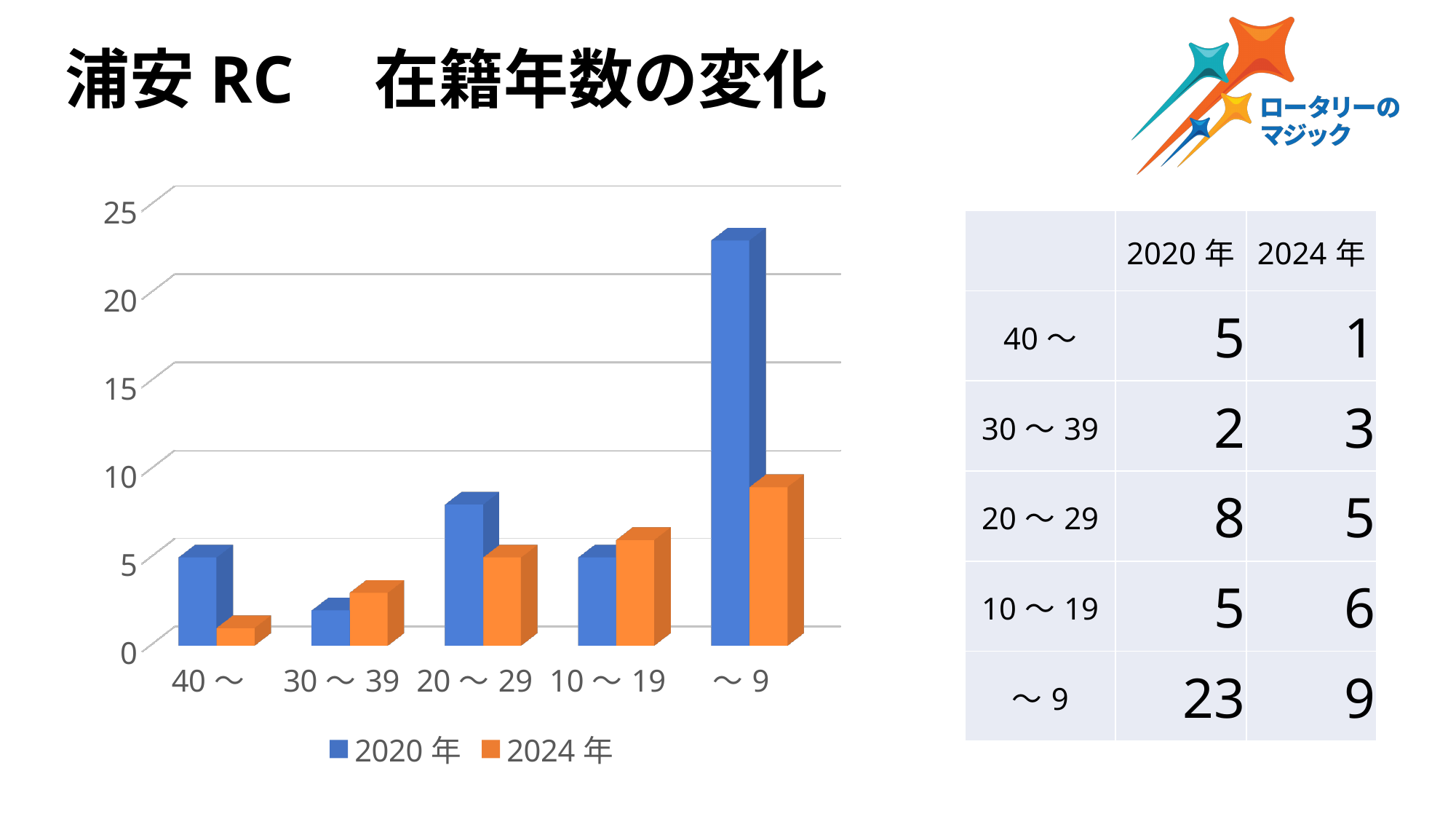
How many series does the chart legend list? 2 How many categories are shown on the x axis of the chart? 5 Which category has the highest 2020年 value? ～9 What is the 2024年 value for the 40～ category? 1 Which colour represents the 2024年 series in the chart? orange Which category has the lowest 2024年 value? 40～ What is the 2020年 value for the 20～29 category? 8 For the 10～19 category, which is larger, the 2020年 value or the 2024年 value? 2024年 Is the 2020年 value for the ～9 category greater or less than 20? greater What is the difference between the 2020年 and 2024年 values for the ～9 category? 14 What is the 2020年 value for the ～9 category? 23 What kind of chart is shown on the slide? bar chart